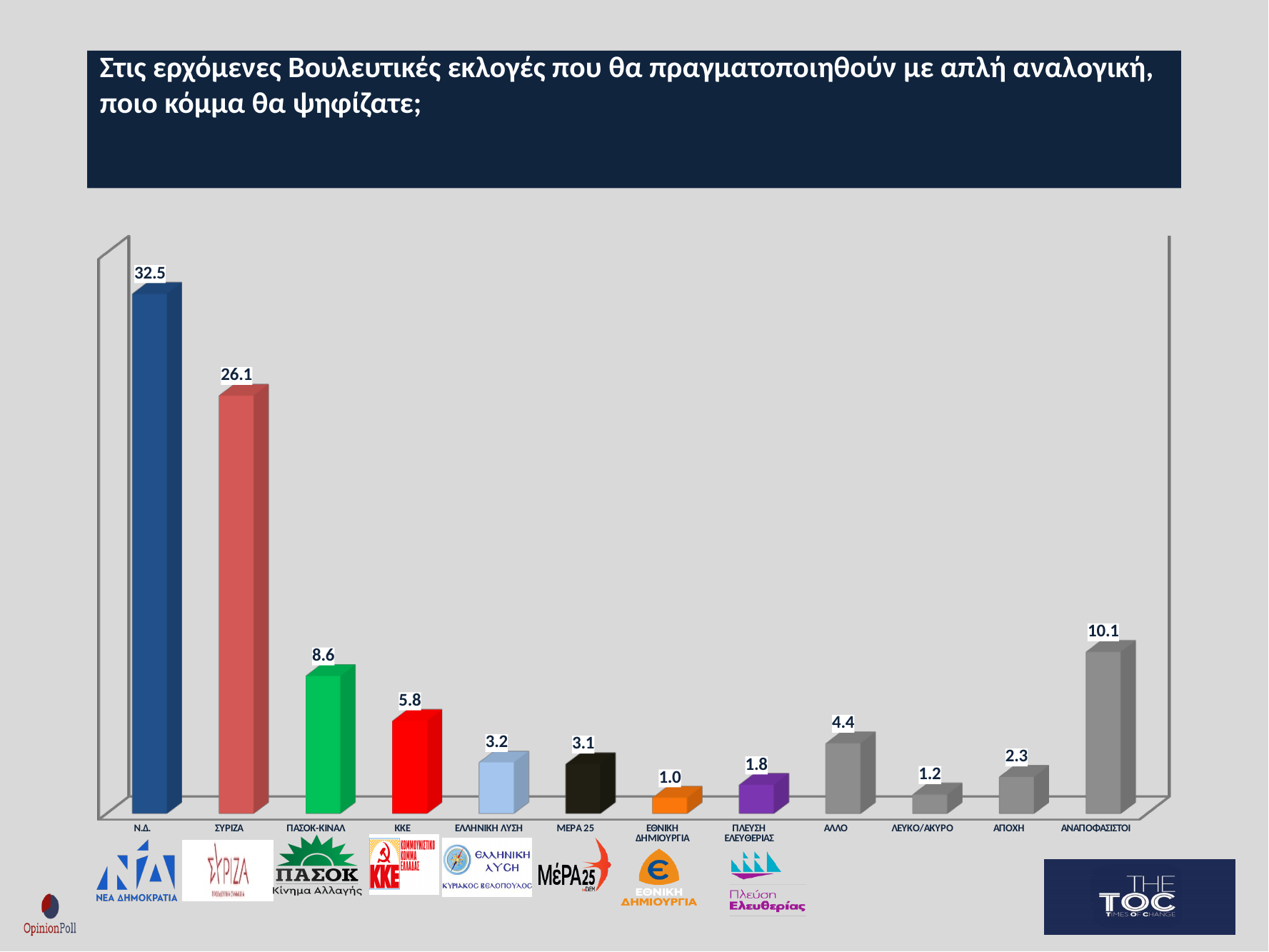
What is the value for ΑΝΑΠΟΦΑΣΙΣΤΟΙ? 10.1 What is the value for ΣΥΡΙΖΑ? 26.1 What is the difference between the values for ΑΠΟΧΗ and ΛΕΥΚΟ/ΑΚΥΡΟ? 1.1 How many categories are shown in the chart? 12 Which is larger, the value for ΚΚΕ or the value for ΑΛΛΟ? ΚΚΕ Which category has the highest value? Ν.Δ. What colour is the bar for ΠΑΣΟΚ-ΚΙΝΑΛ? Green What kind of chart is shown on the slide? Bar chart What is the difference between the values for Ν.Δ. and ΣΥΡΙΖΑ? 6.4 Which category has the lowest value? ΕΘΝΙΚΗ ΔΗΜΙΟΥΡΓΙΑ What is the value for ΠΑΣΟΚ-ΚΙΝΑΛ? 8.6 What is the value for Ν.Δ.? 32.5